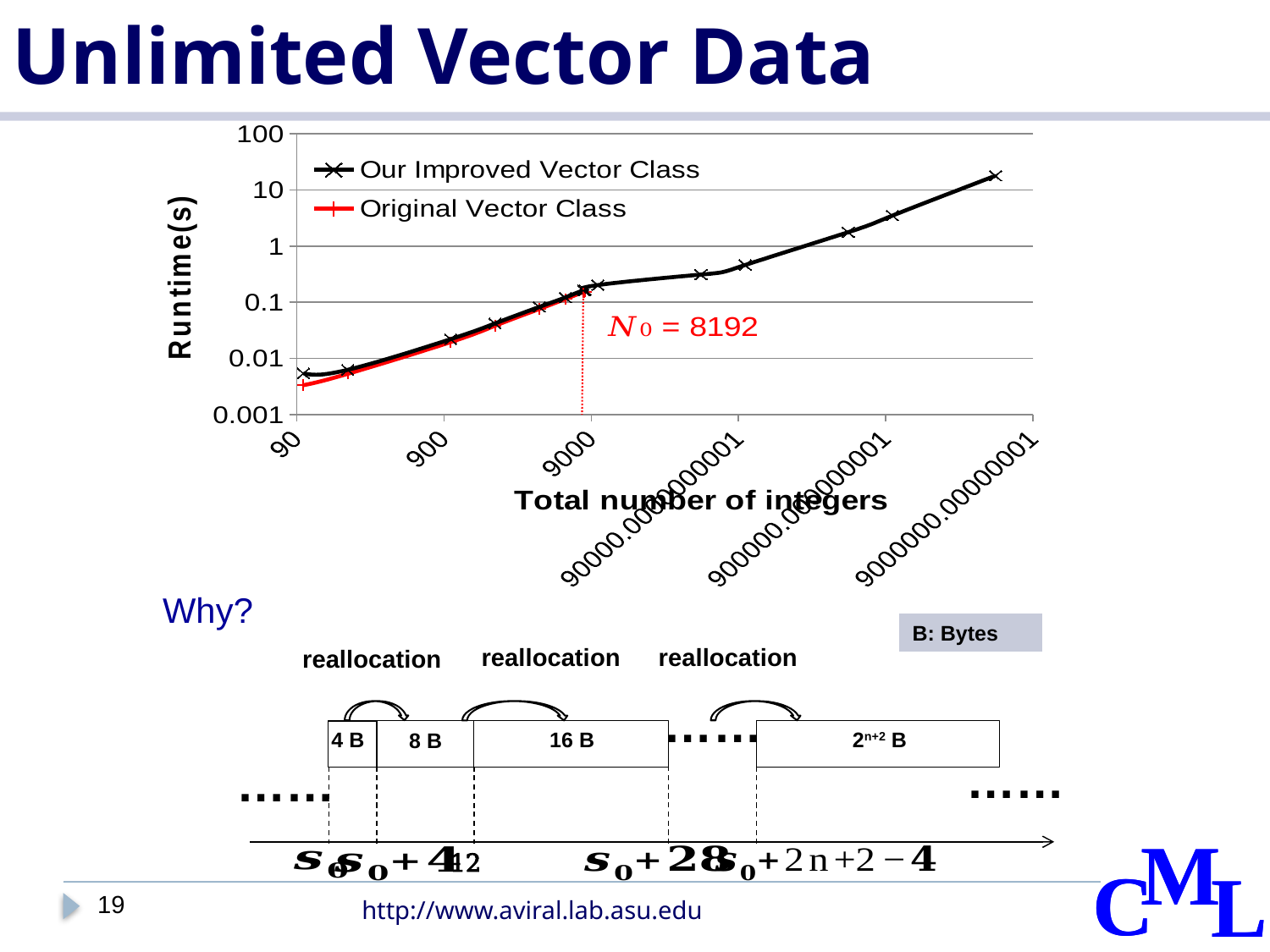
What are the two series named in the chart's legend? Our Improved Vector Class and Original Vector Class Which series extends to the largest total number of integers on the chart? Our Improved Vector Class How many tick labels are shown on the chart's x axis? 6 Do the runtime values for Our Improved Vector Class rise or fall as the total number of integers increases? rise What is the label of the chart's vertical axis? Runtime(s) What kind of chart is shown on the slide? line chart How many series does the chart's legend list? 2 Is the runtime of Our Improved Vector Class at its rightmost point greater or less than 10? greater What value of N0 is annotated on the chart? 8192